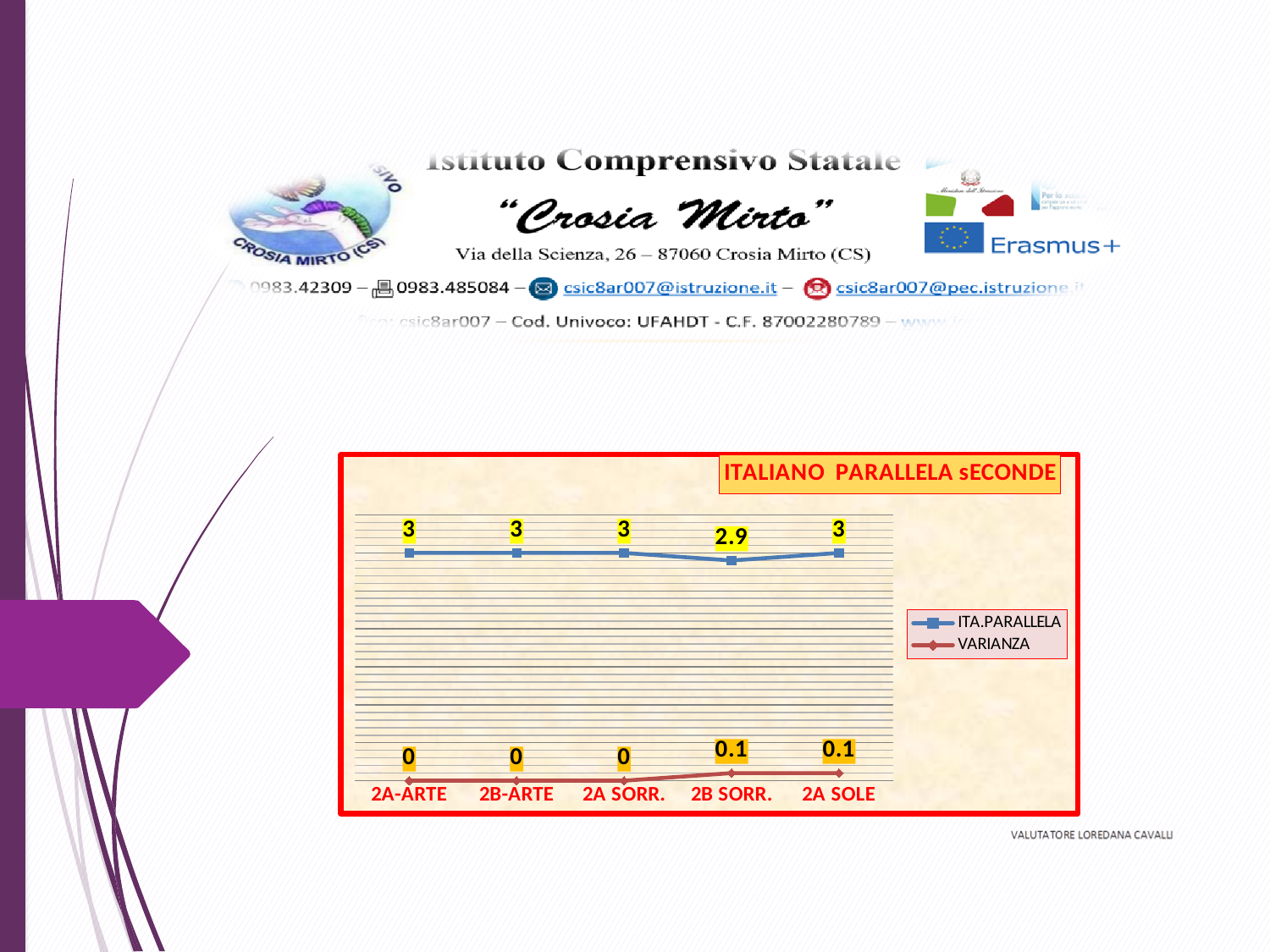
What is the VARIANZA value for 2B-ARTE? 0 What kind of chart is shown on the slide? line chart How many categories are shown on the x axis? 5 How many series does the legend list? 2 Which series is drawn in red in the legend? VARIANZA What is the ITA.PARALLELA value for 2B SORR.? 2.9 What is the ITA.PARALLELA value for 2A-ARTE? 3 What is the VARIANZA value for 2A SOLE? 0.1 What is the title of the chart? ITALIANO PARALLELA sECONDE What is the difference between the ITA.PARALLELA value for 2A SORR. and the ITA.PARALLELA value for 2B SORR.? 0.1 Which category has the lowest ITA.PARALLELA value? 2B SORR. Which is larger: the VARIANZA value for 2A SORR. or the VARIANZA value for 2B SORR.? 2B SORR.